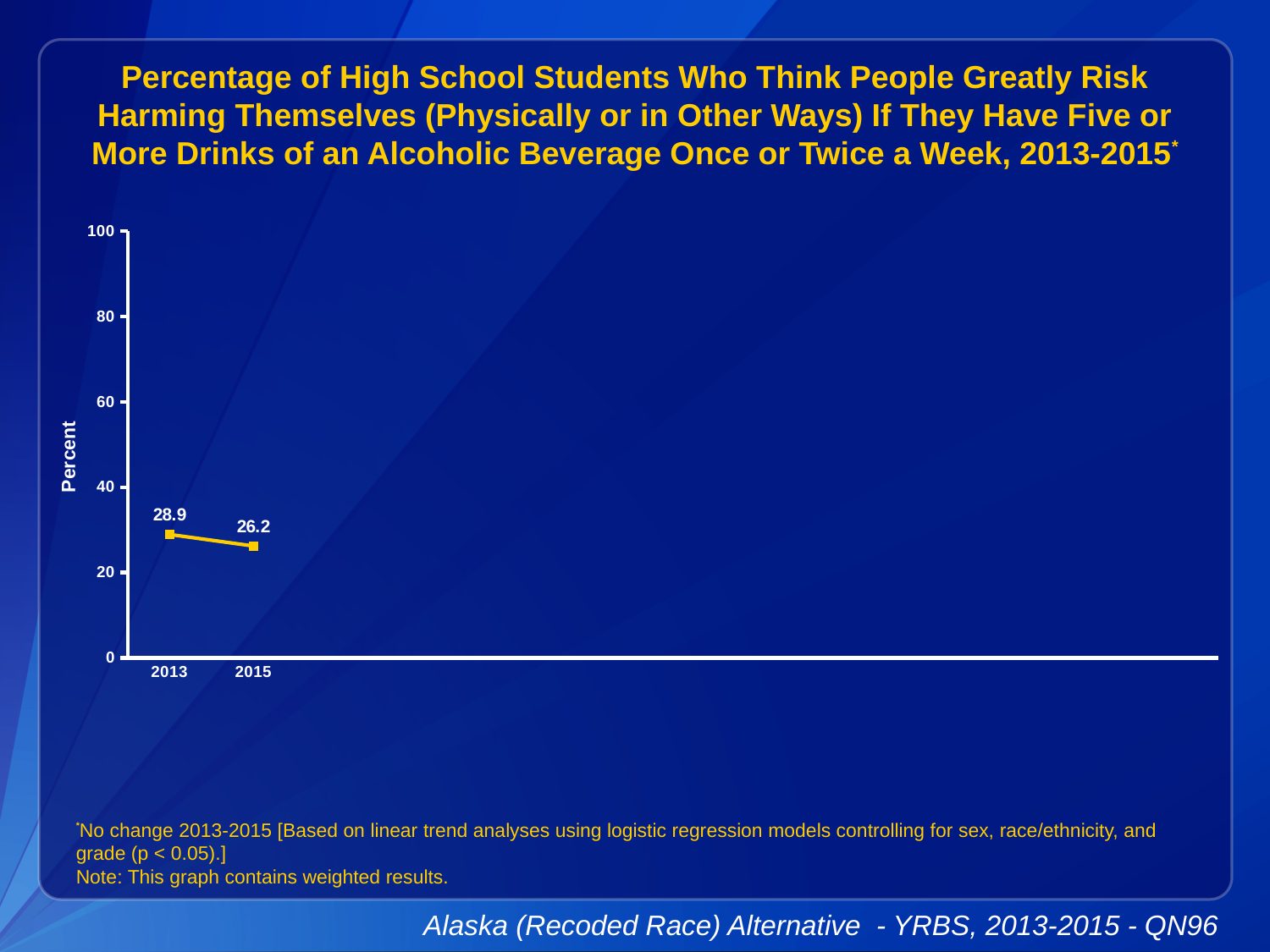
What is the difference between the 2013 and 2015 values? 2.7 How many data points are plotted on the chart? 2 Do the values rise or fall from 2013 to 2015? fall Which year has the lower value? 2015 What is the value for 2015? 26.2 Is the value for 2015 greater or less than 40? less What is the value for 2013? 28.9 Is the value for 2013 larger or smaller than the value for 2015? larger Which year has the higher value? 2013 What kind of chart is shown on the slide? line chart What is the maximum value shown on the y axis? 100 What is the label on the y axis? Percent